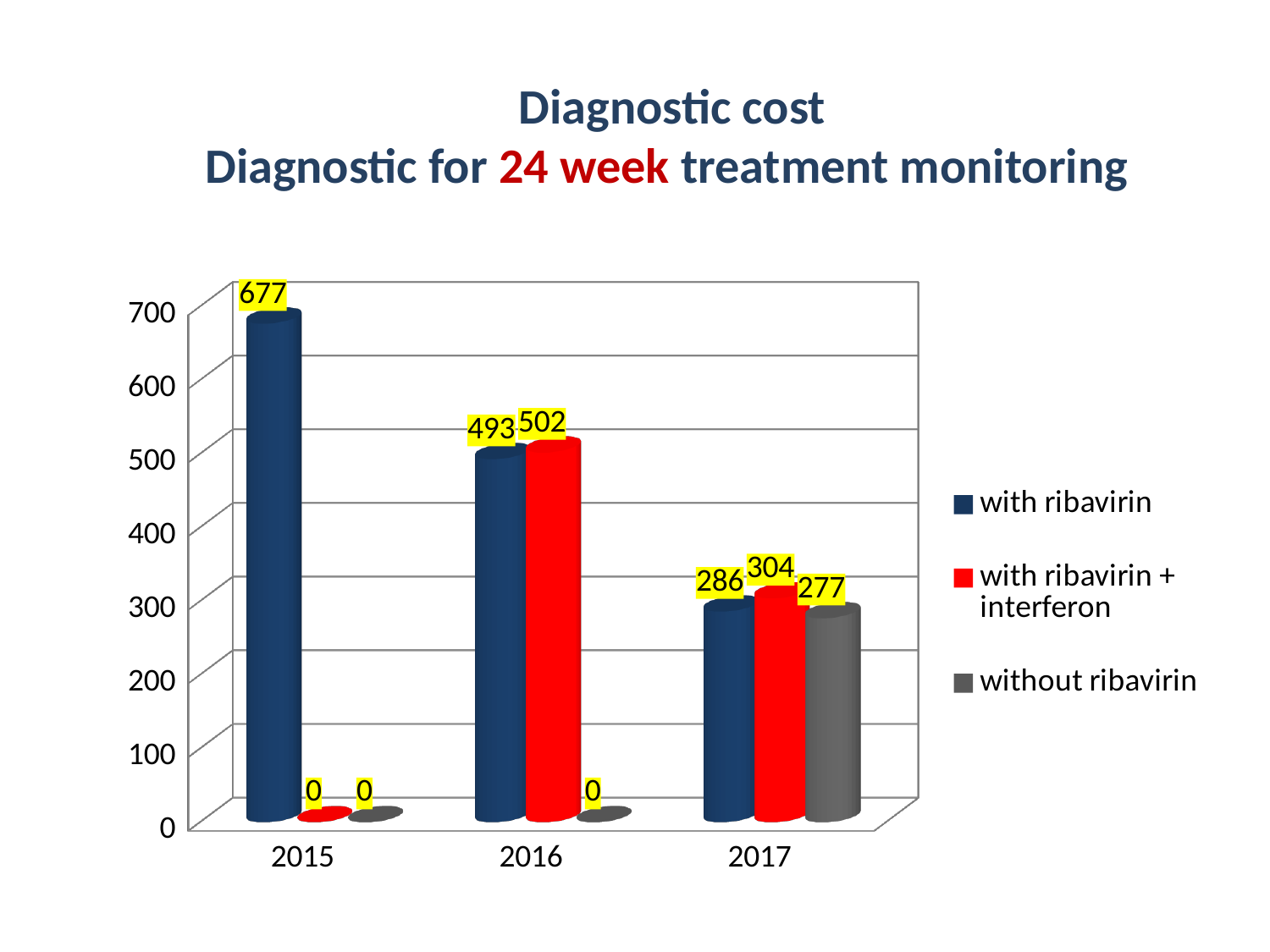
What kind of chart is shown on the slide? bar chart What is the value for "with ribavirin + interferon" in 2015? 0 How many series does the legend list? 3 In 2017, which is larger: "with ribavirin" or "with ribavirin + interferon"? with ribavirin + interferon What is the difference between the "with ribavirin" values for 2015 and 2016? 184 Does the value for "with ribavirin" rise or fall from 2015 to 2017? fall What is the value for "with ribavirin + interferon" in 2016? 502 What is the value for "without ribavirin" in 2017? 277 In which year is the value for "with ribavirin" highest? 2015 What is the value for "with ribavirin" in 2015? 677 In which year is the value for "with ribavirin" lowest? 2017 How many years are shown on the x axis? 3